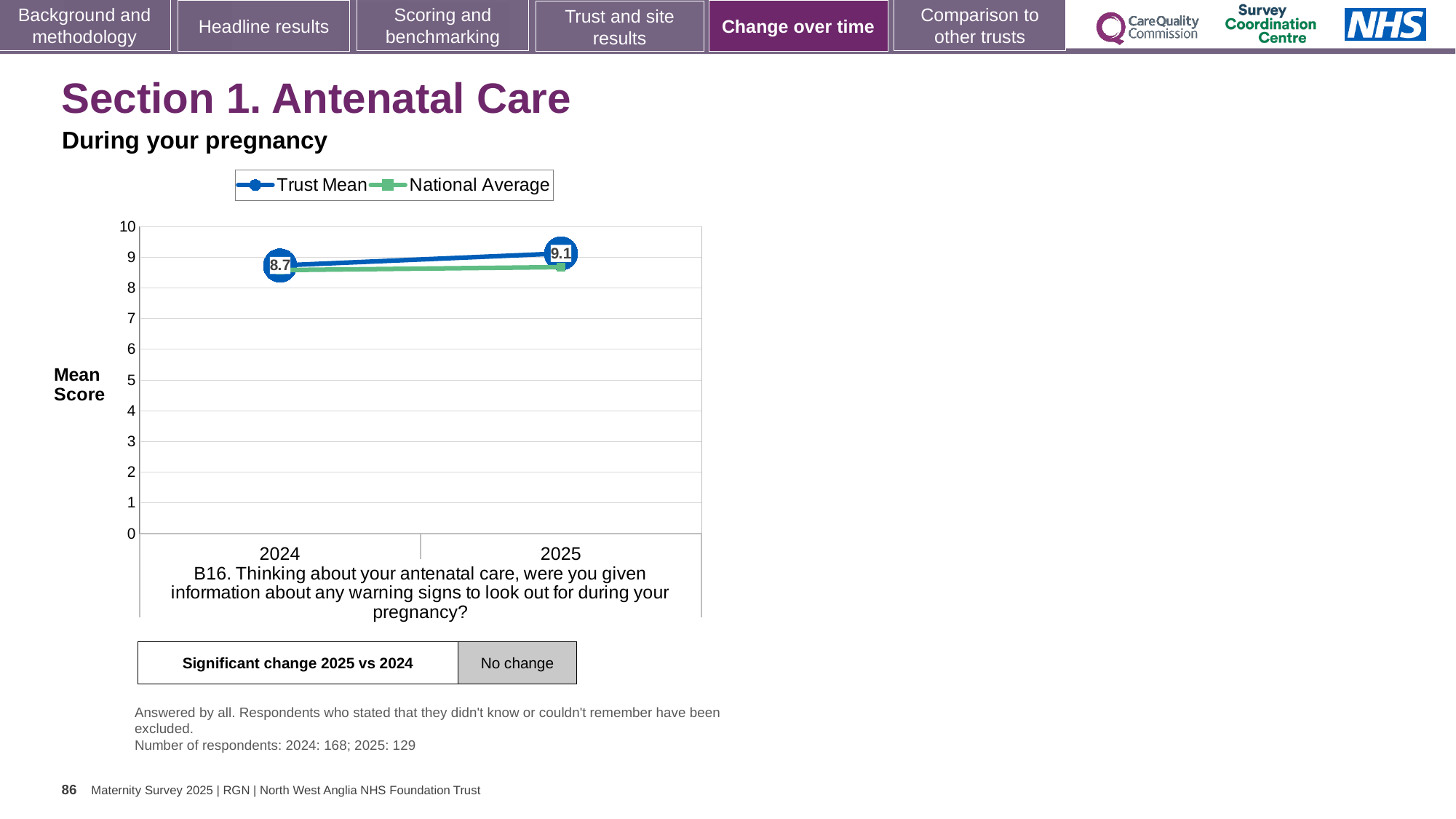
How many years are plotted on the x axis? 2 Does the Trust Mean rise or fall from 2024 to 2025? rise Is the Trust Mean score for 2025 higher or lower than for 2024? higher How many series does the legend list? 2 Which year has the higher Trust Mean score? 2025 What is the Trust Mean score for 2025? 9.1 What is the Trust Mean score for 2024? 8.7 What kind of chart is shown? line chart What is the label on the y axis? Mean Score By how much did the Trust Mean score change from 2024 to 2025? 0.4 Which year has the lower Trust Mean score? 2024 Is the National Average for 2024 greater or less than 8? greater